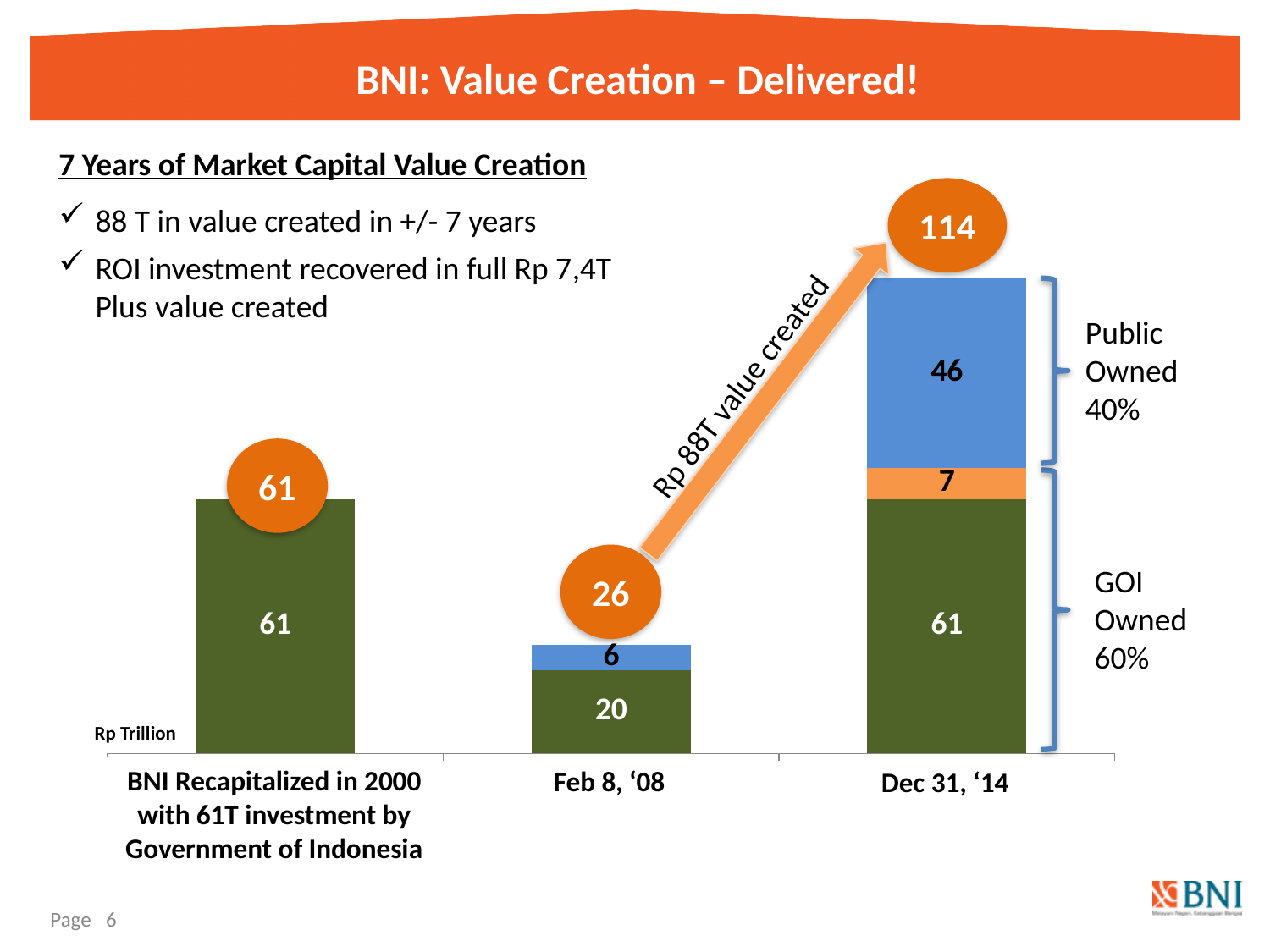
What is the difference between the total for Dec 31, '14 and the total for Feb 8, '08? 88 What type of chart is shown on the slide? Stacked bar chart What unit is the chart's values expressed in? Rp Trillion Which date has the highest total value? Dec 31, '14 What is the value of the green (bottom) segment of the Feb 8, '08 bar? 20 What is the value of the blue (top) segment of the Dec 31, '14 bar? 46 Which date has the lowest total value? Feb 8, '08 What is the value of the orange (middle) segment of the Dec 31, '14 bar? 7 How many bars are shown in the chart? 3 What is the total value shown for Feb 8, '08? 26 Which is larger, the total for Feb 8, '08 or the total for the 2000 recapitalization bar? The 2000 recapitalization bar (61) What is the total market capital value shown for Dec 31, '14? 114